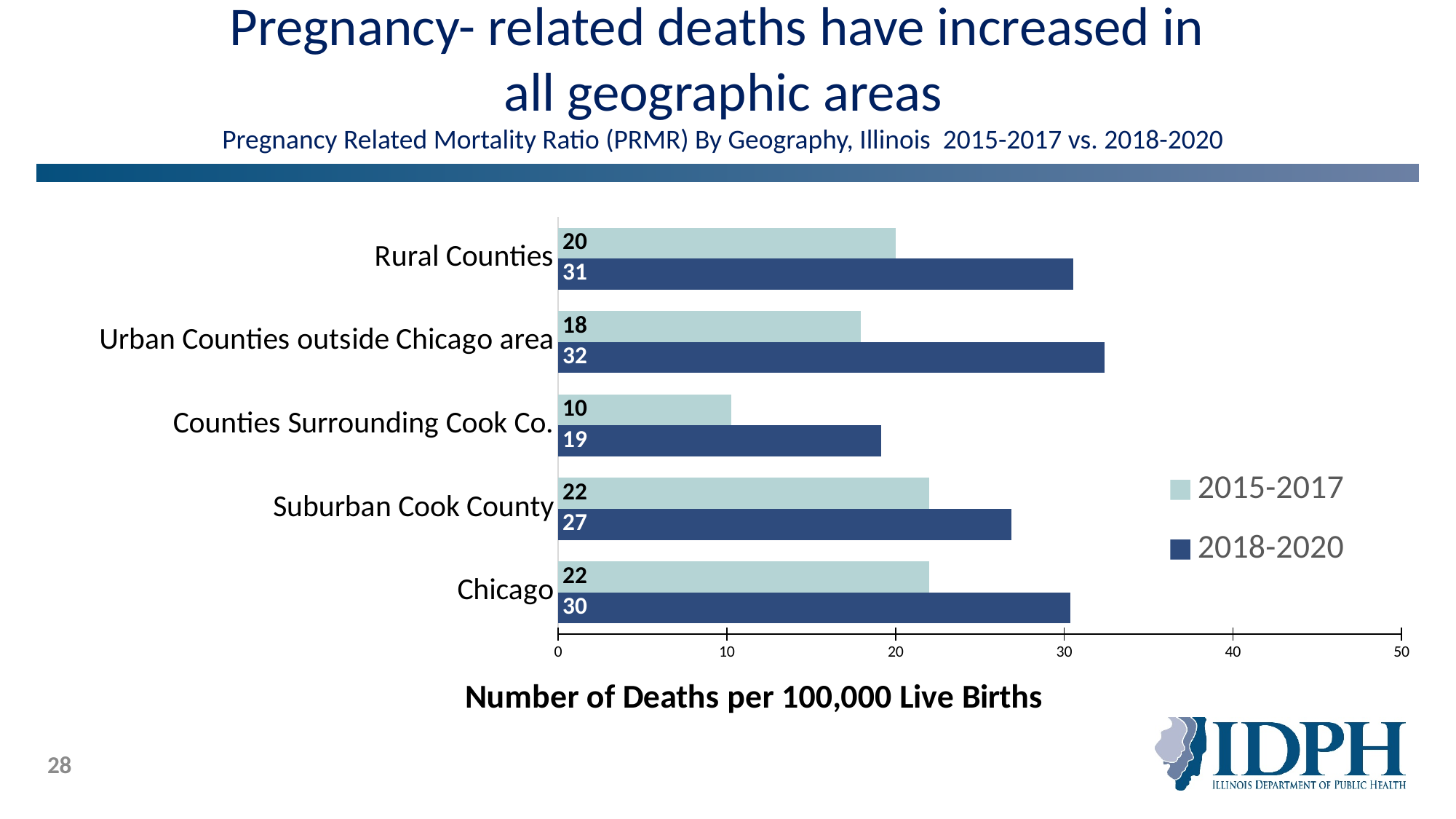
Is the 2018-2020 value for Counties Surrounding Cook Co. greater or less than 20? less What kind of chart is shown on the slide? Bar chart What is the 2018-2020 value for Rural Counties? 31 What is the label of the horizontal axis? Number of Deaths per 100,000 Live Births Which geographic area has the lowest 2015-2017 value? Counties Surrounding Cook Co. Which geographic area has the highest 2018-2020 value? Urban Counties outside Chicago area What is the 2018-2020 value for Chicago? 30 What is the 2015-2017 value for Counties Surrounding Cook Co.? 10 How many geographic areas are shown on the chart? 5 Which is larger for Suburban Cook County: the 2015-2017 value or the 2018-2020 value? 2018-2020 What is the difference between the 2018-2020 and 2015-2017 values for Urban Counties outside Chicago area? 14 How many series does the legend list? 2